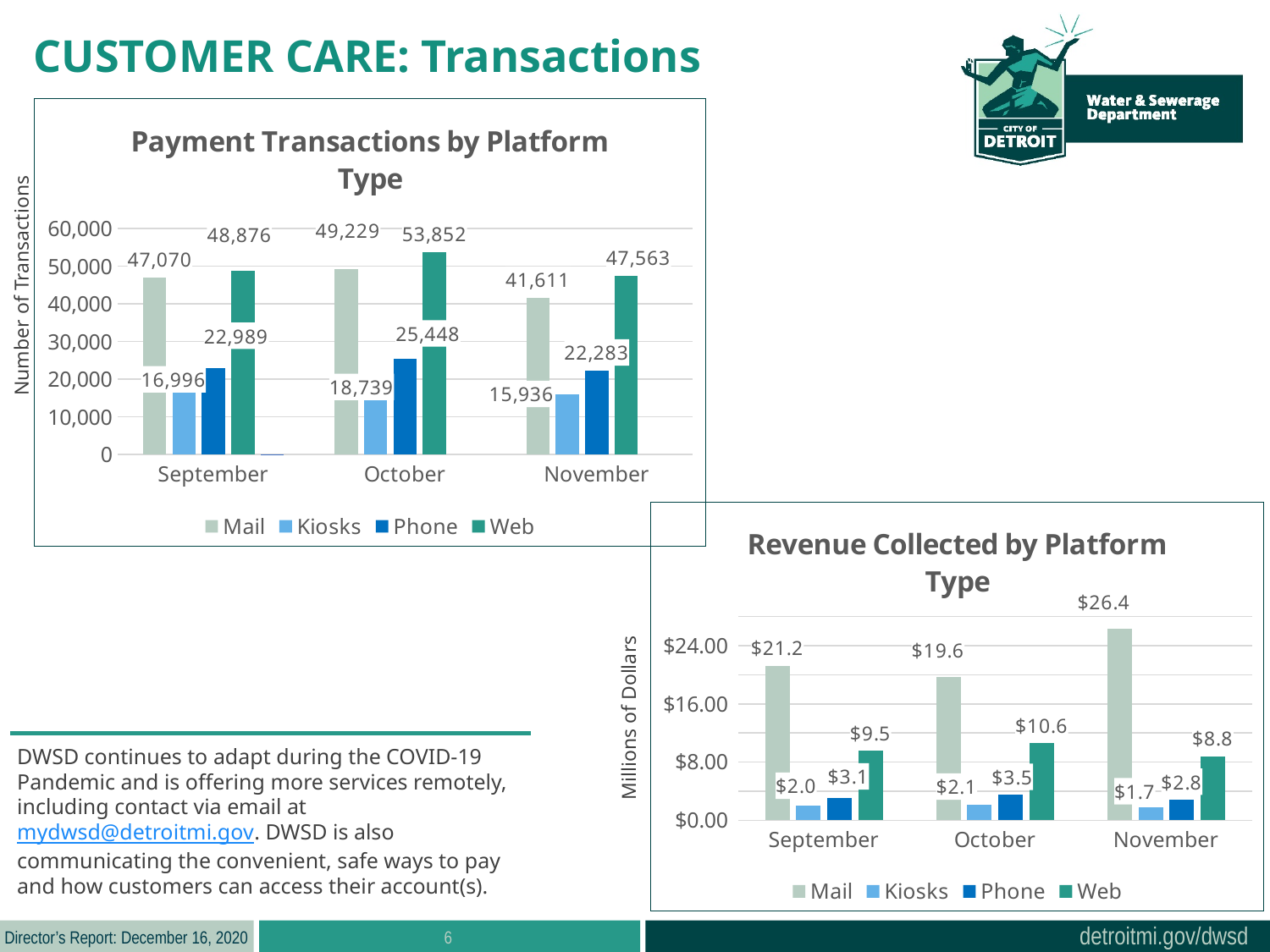
How many months are shown on the x axis of the Revenue Collected by Platform Type chart? 3 What kind of chart is the Revenue Collected by Platform Type chart? Bar chart In the Revenue Collected by Platform Type chart, is the Mail revenue for October greater or less than $16.00? greater In the Revenue Collected by Platform Type chart, what is the difference between Web and Phone revenue in November? $6.0 In the Revenue Collected by Platform Type chart, how does Web revenue change from September to October to November? Rises then falls In the Payment Transactions by Platform Type chart, how many Web transactions were there in October? 53,852 In the Revenue Collected by Platform Type chart, how much revenue was collected by Mail in November? $26.4 In the Payment Transactions by Platform Type chart, which platform had the fewest transactions in November? Kiosks In the Payment Transactions by Platform Type chart, which had more transactions in September, Mail or Web? Web In the Payment Transactions by Platform Type chart, which month had the highest number of Web transactions? October In the Payment Transactions by Platform Type chart, how many more Web transactions than Mail transactions were there in October? 4,623 How many series does the legend of the Payment Transactions by Platform Type chart list? 4